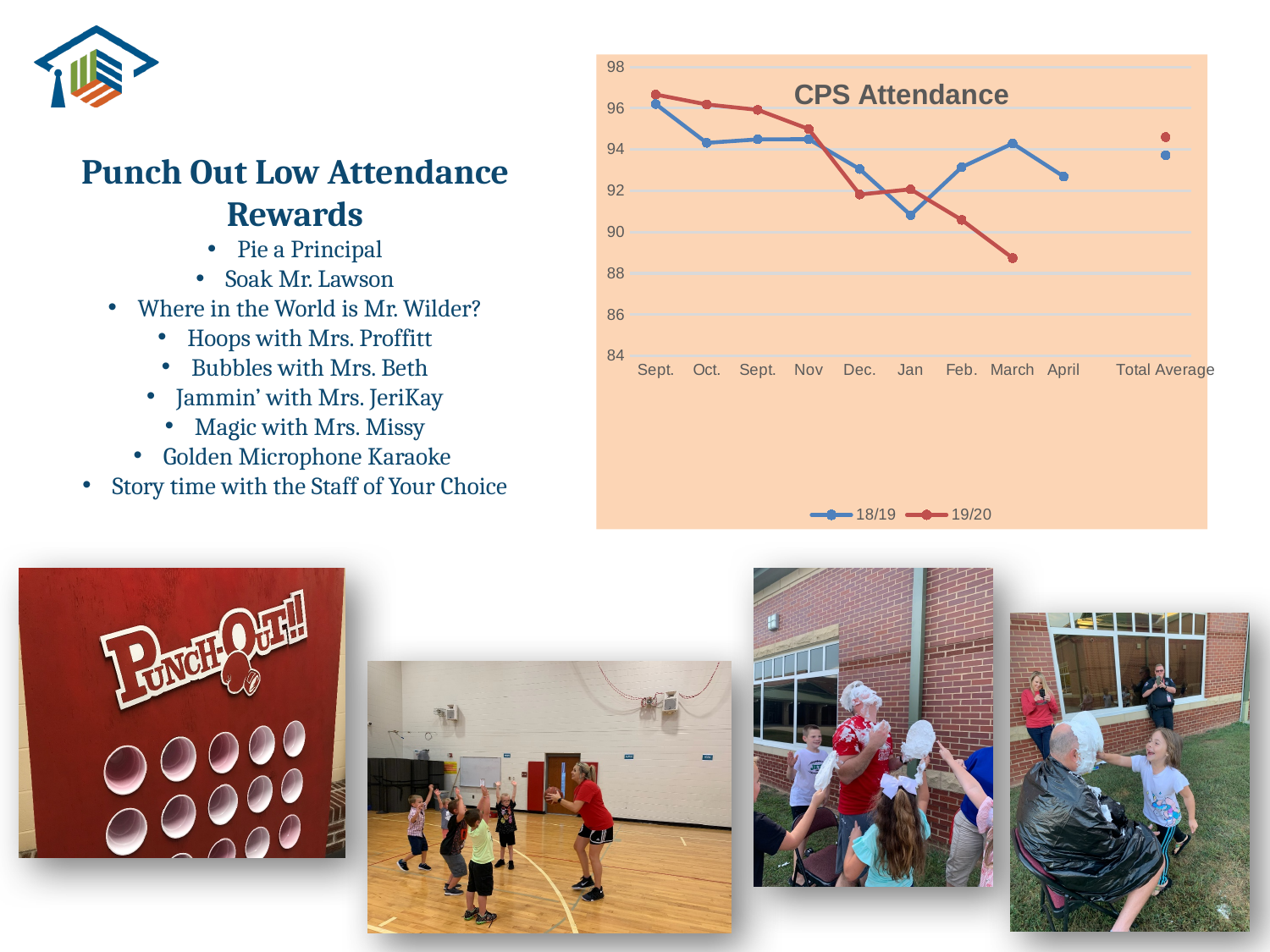
In the CPS Attendance chart, which series has the higher value in March, 18/19 or 19/20? 18/19 How many series does the legend of the CPS Attendance chart list? 2 In the CPS Attendance chart, is the 19/20 value for March greater or less than 90? less In the CPS Attendance chart, which category has the highest value for the 19/20 series? Sept. (the first one) In the CPS Attendance chart, does the 19/20 series generally rise or fall from Sept. to March? fall In the CPS Attendance chart, is the 19/20 value for the first Sept. greater or less than 96? greater In the CPS Attendance chart, which month has the lowest value for the 18/19 series? Jan What kind of chart is the CPS Attendance chart? line chart In the CPS Attendance chart, is the 18/19 value for Jan greater or less than 92? less In the CPS Attendance chart, which month has the lowest value for the 19/20 series? March How many categories are shown along the x axis of the CPS Attendance chart? 10 What are the two series named in the legend of the CPS Attendance chart? 18/19 and 19/20